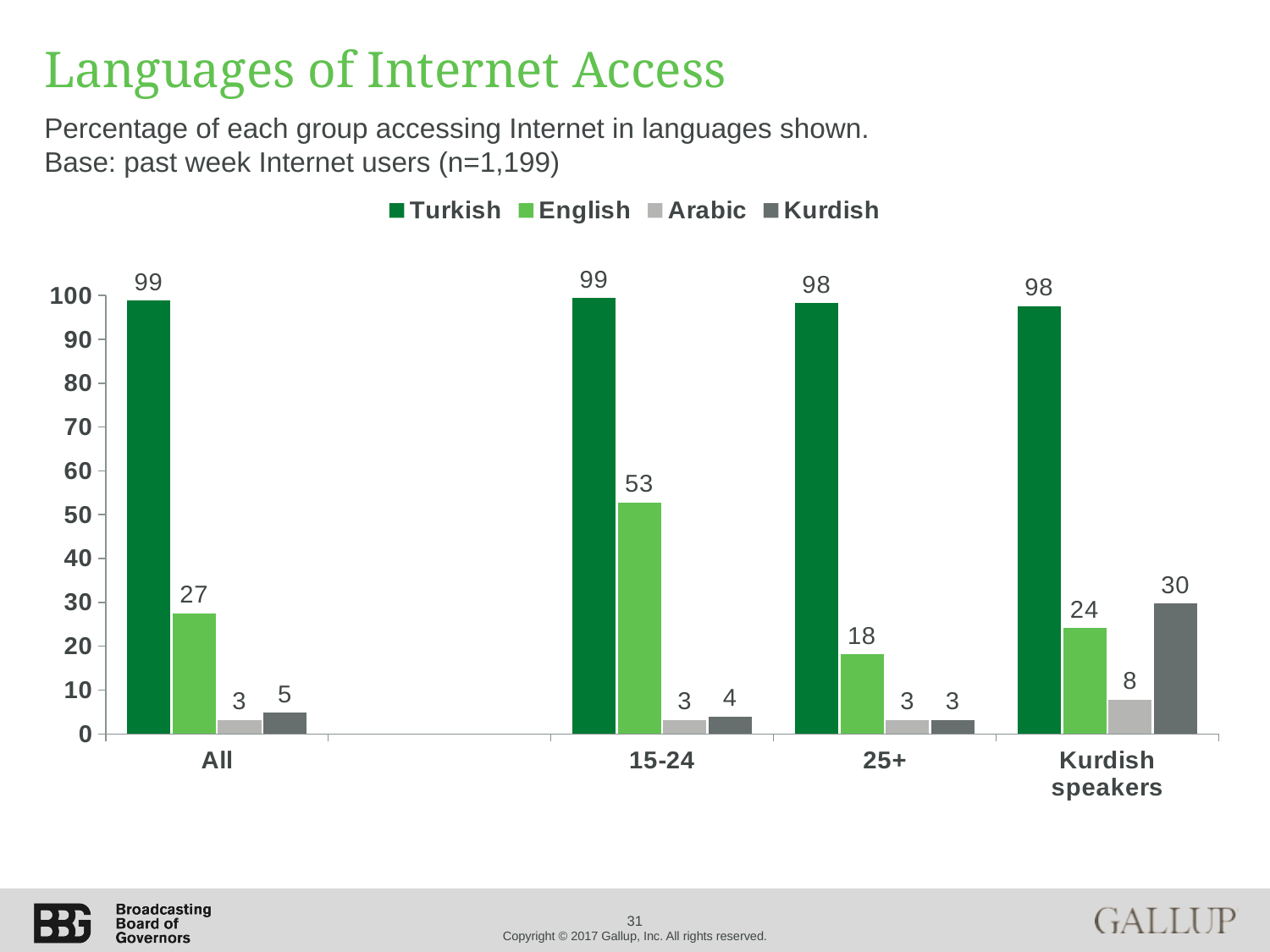
Which is larger for Kurdish speakers: the English value or the Kurdish value? Kurdish How many groups are shown on the x axis? 4 What is the Arabic value for the All group? 3 How many series does the legend list? 4 Which group has the lowest English value? 25+ What percentage of the 15-24 group accesses the Internet in English? 53 Which group has the highest English value? 15-24 What kind of chart is shown on the slide? Bar chart What is the title of the slide's chart? Languages of Internet Access What is the English value for the 25+ group? 18 What is the Kurdish value for Kurdish speakers? 30 What is the difference between the English values for the 15-24 and 25+ groups? 35